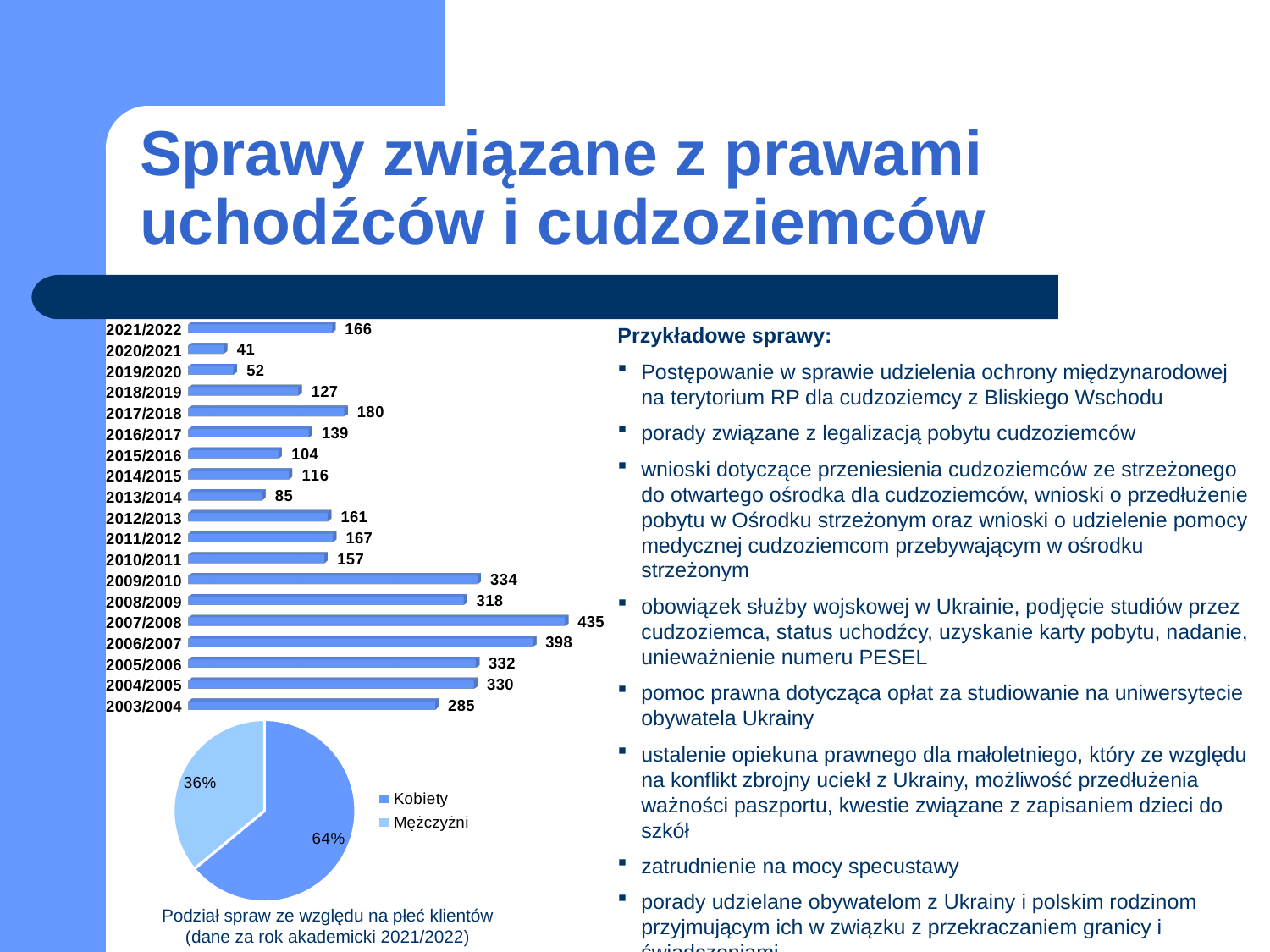
In the pie chart at the bottom left, which academic year does the caption say the data is for? 2021/2022 In the pie chart at the bottom left, what share is labelled for Kobiety? 64% In the bar chart on the left, what is the difference between the values for 2006/2007 and 2005/2006? 66 What kind of chart is the chart on the left showing values by academic year? bar chart In the pie chart at the bottom left, what share is labelled for Mężczyźni? 36% How many entries does the legend of the pie chart at the bottom left list? 2 In the bar chart on the left, which academic year has the lowest value? 2020/2021 In the bar chart on the left, what is the value for 2007/2008? 435 In the bar chart on the left, which academic year has the highest value? 2007/2008 In the bar chart on the left, how many academic years are shown? 19 In the bar chart on the left, what is the value for 2021/2022? 166 In the bar chart on the left, which is larger: the value for 2017/2018 or the value for 2016/2017? 2017/2018